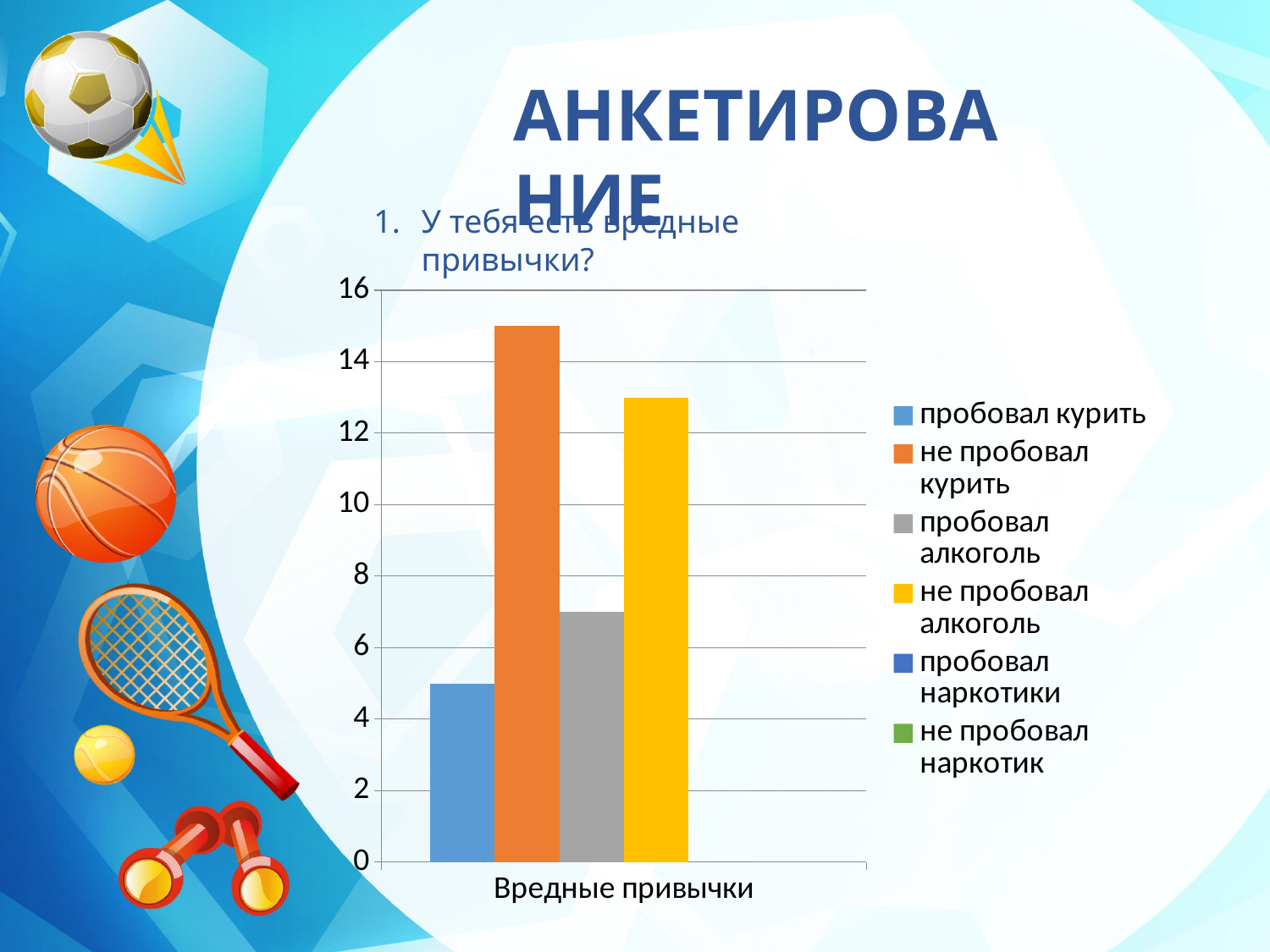
How many categories are shown on the x axis of the chart? 1 Is the value for 'не пробовал алкоголь' greater or less than 12? greater Which series has the tallest bar in the chart? не пробовал курить Is the value for 'пробовал курить' greater or less than 6? less How many series does the chart legend list? 6 What is the category label on the x axis of the chart? Вредные привычки Is the value for 'не пробовал курить' greater or less than 14? greater Which series is shown in yellow in the chart legend? не пробовал алкоголь Which bar is taller: 'пробовал курить' or 'пробовал алкоголь'? пробовал алкоголь What kind of chart is shown on the slide? bar chart Which bar is taller: 'не пробовал курить' or 'не пробовал алкоголь'? не пробовал курить